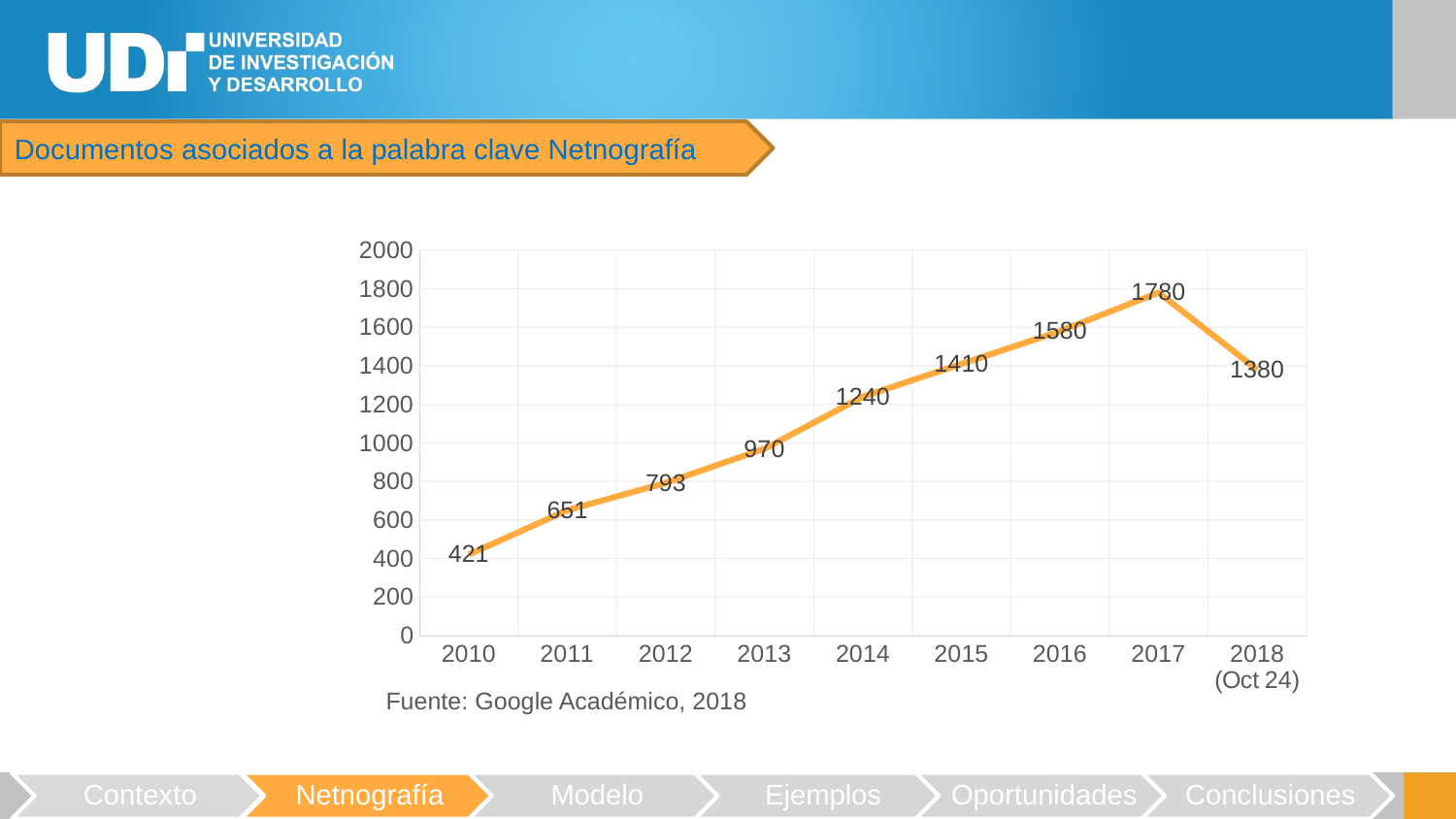
What kind of chart is shown on the slide? line chart Which year has the lowest value? 2010 Which year has the highest value? 2017 What is the value for 2018 (Oct 24)? 1380 What is the difference between the values for 2017 and 2018 (Oct 24)? 400 What is the difference between the values for 2013 and 2012? 177 Which is larger, the value for 2015 or the value for 2016? 2016 Is the value for 2011 greater or less than 800? less What is the value for 2014? 1240 Do the values rise or fall from 2010 to 2017? rise What is the value for 2010? 421 How many years are plotted on the x axis? 9